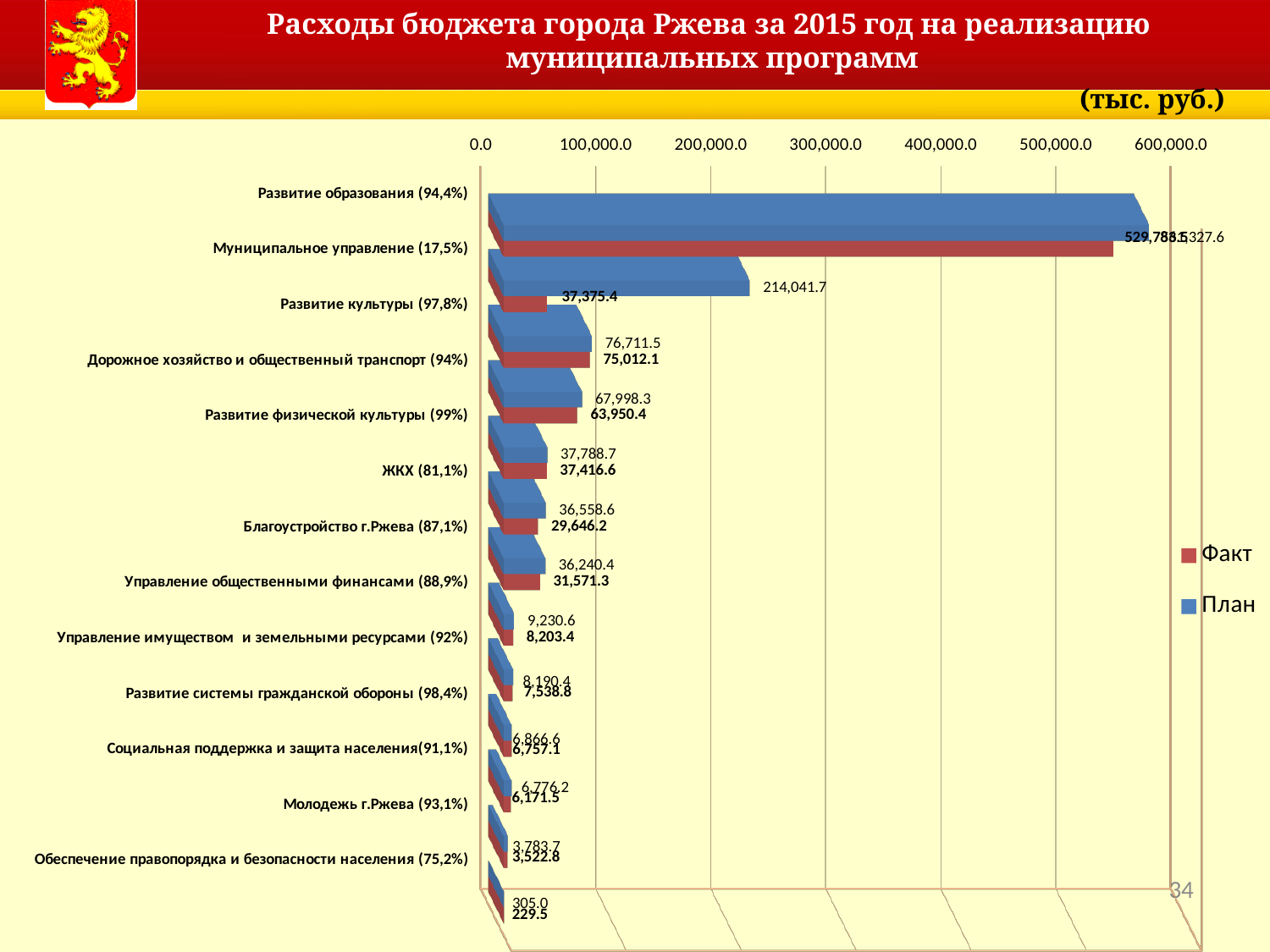
What is the Факт value for Развитие культуры (97,8%)? 75,012.1 How many series does the legend list? 2 What is the difference between the План and Факт values for Муниципальное управление (17,5%)? 176,666.3 What is the План value for ЖКХ (81,1%)? 36,558.6 Which category has the lowest Факт value? Обеспечение правопорядка и безопасности населения (75,2%) Which is larger for Дорожное хозяйство и общественный транспорт (94%): the План value or the Факт value? План Is the План value for Развитие образования (94,4%) greater or less than 500,000.0? greater Which category has the highest План value? Развитие образования (94,4%) What is the Факт value for Муниципальное управление (17,5%)? 37,375.4 How many categories are shown in the chart? 13 What is the Факт value for Обеспечение правопорядка и безопасности населения (75,2%)? 229.5 What is the План value for Муниципальное управление (17,5%)? 214,041.7